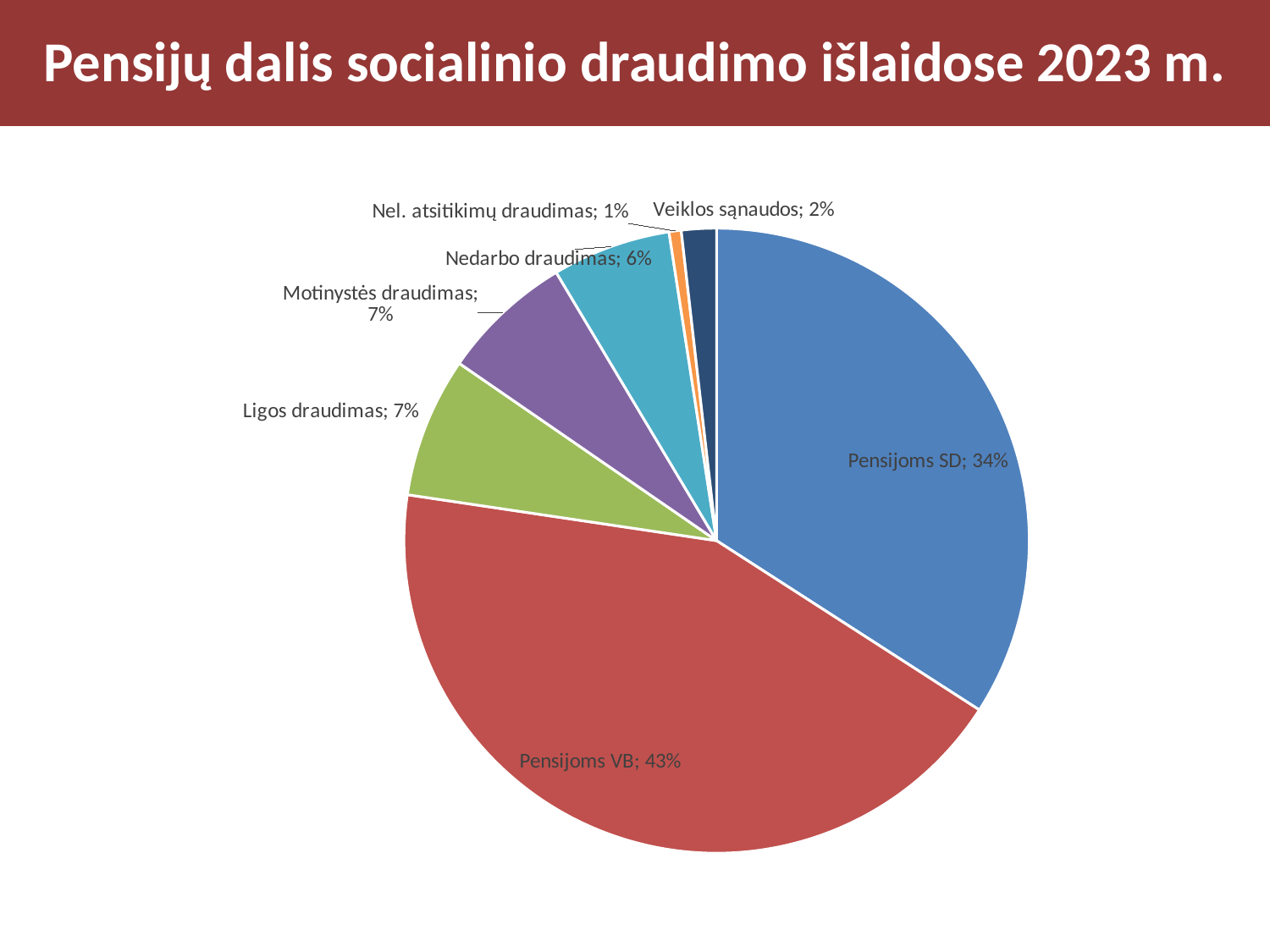
Which category has the smallest slice of the pie? Nel. atsitikimų draudimas What kind of chart is shown on the slide? Pie chart What share of the pie does Pensijoms VB have? 43% What is the combined share of Pensijoms SD and Pensijoms VB? 77% What is the value shown for Nedarbo draudimas? 6% What is the title of the slide? Pensijų dalis socialinio draudimo išlaidose 2023 m. How many slices does the pie chart have? 7 What is the difference between the shares of Pensijoms VB and Pensijoms SD? 9% Which is larger, the share for Nedarbo draudimas or the share for Veiklos sąnaudos? Nedarbo draudimas Which category has the largest slice of the pie? Pensijoms VB What is the value shown for Pensijoms SD? 34% What is the value shown for Veiklos sąnaudos? 2%